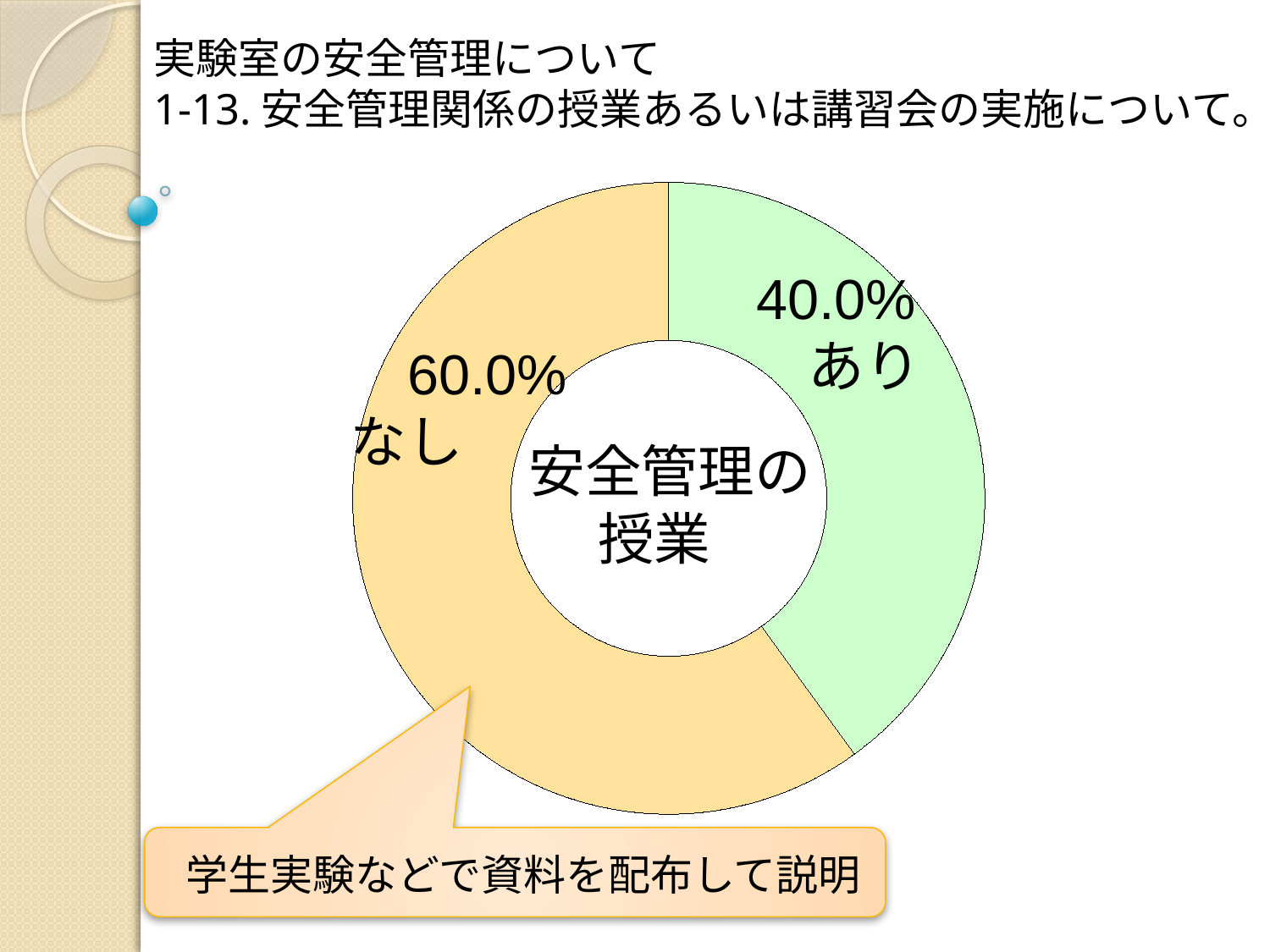
What is the difference in percentage points between なし and あり? 20.0% What text is written in the centre of the doughnut chart? 安全管理の授業 What percentage of the chart is labelled なし? 60.0% Is the share for あり greater or less than 50%? less What percentage of the chart is labelled あり? 40.0% Which category has the larger share, あり or なし? なし Which category has the largest share in the chart? なし What is the total of the two segments shown in the chart? 100.0% What colour is the あり segment of the chart? Green What kind of chart is shown on the slide? Doughnut (pie) chart How many categories are shown in the chart? 2 Which category has the smallest share in the chart? あり